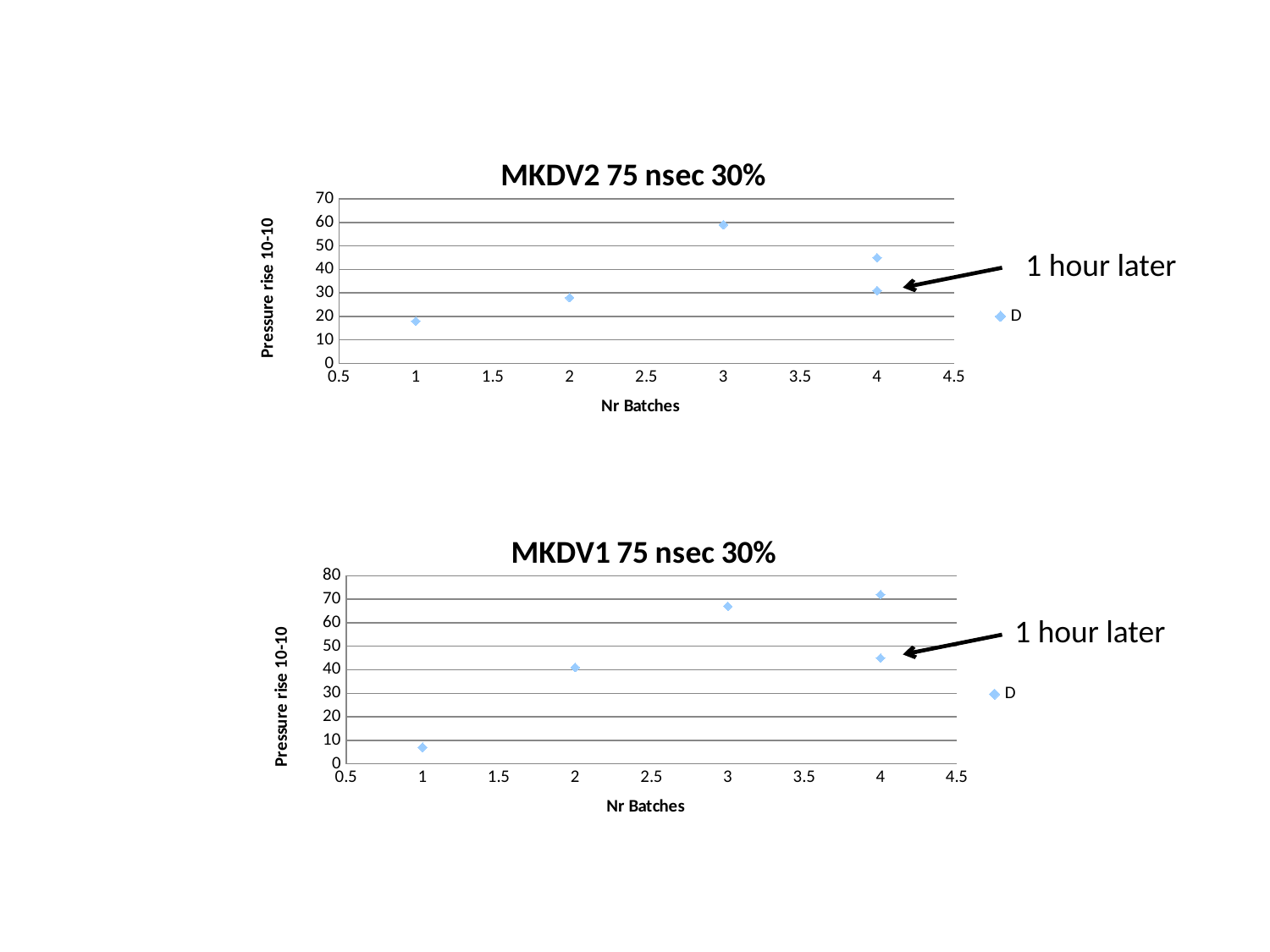
In the bottom chart (MKDV1 75 nsec 30%), is the value at 3 batches greater or less than 60? greater In the top chart (MKDV2 75 nsec 30%), is the value at 3 batches greater or less than 50? greater What is the x-axis label of the bottom chart (MKDV1 75 nsec 30%)? Nr Batches In the bottom chart (MKDV1 75 nsec 30%), how many series does the legend list? 1 In the top chart (MKDV2 75 nsec 30%), at which number of batches is the lowest point plotted? 1 In the bottom chart (MKDV1 75 nsec 30%), is the value at 1 batch greater or less than 10? less In the bottom chart (MKDV1 75 nsec 30%), which is larger: the value at 2 batches or the value at 3 batches? 3 batches In the top chart (MKDV2 75 nsec 30%), at which number of batches is the highest point plotted? 3 What kind of chart is the top chart titled "MKDV2 75 nsec 30%"? scatter chart In the bottom chart (MKDV1 75 nsec 30%), do the values generally rise or fall from 1 batch to 3 batches? rise In the top chart (MKDV2 75 nsec 30%), how many data points are plotted? 5